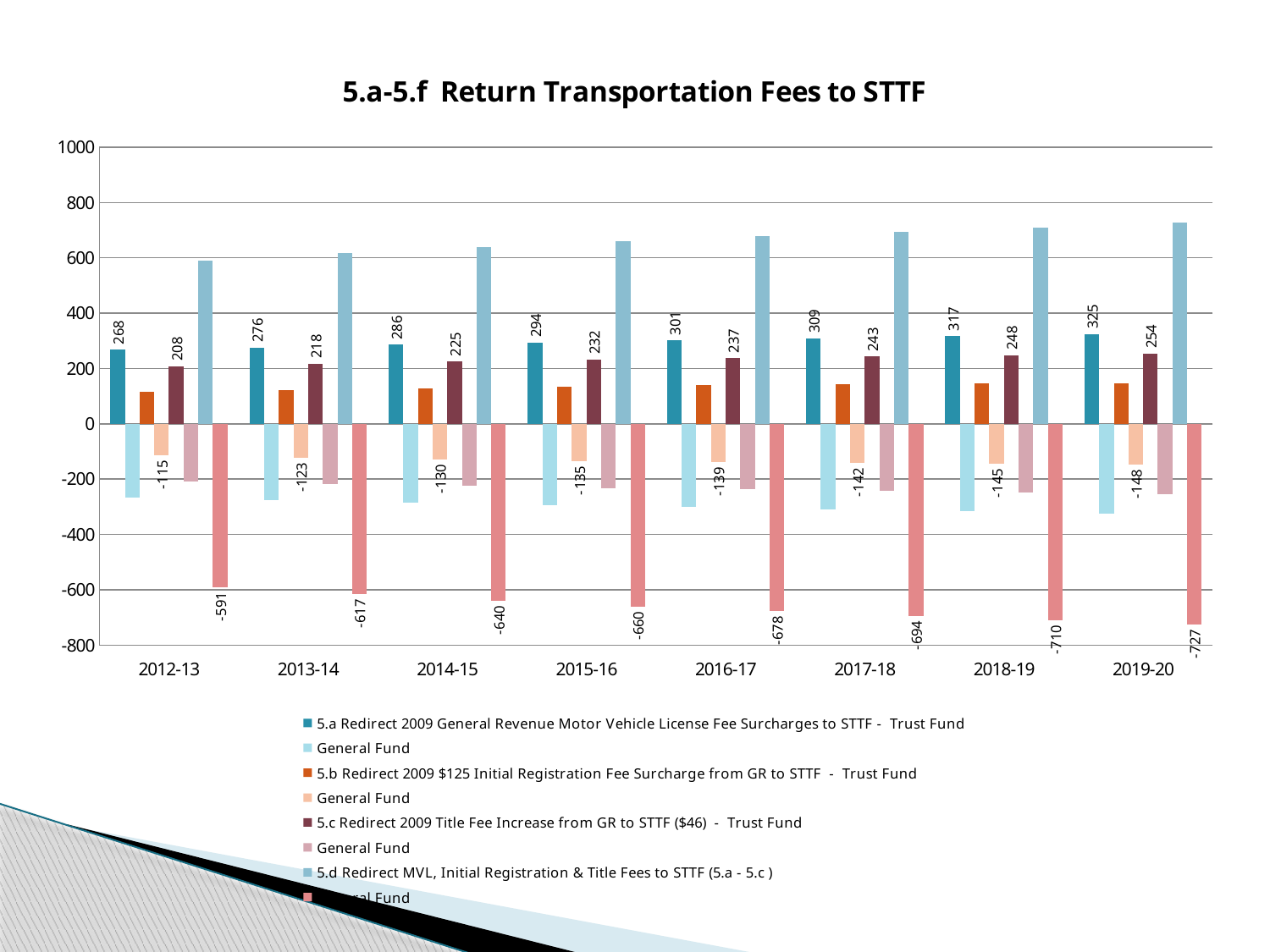
By how much does the 5.a Trust Fund value in 2019-20 exceed its value in 2012-13? 57 How many fiscal years are shown on the x axis? 8 In which year is the 5.a Trust Fund value the highest? 2019-20 Do the 5.a Trust Fund values rise or fall from 2012-13 to 2019-20? Rise What is the General Fund value labelled for 2012-13 in the 5.b Redirect 2009 $125 Initial Registration Fee Surcharge group? -115 What is the value of the 5.c Redirect 2009 Title Fee Increase from GR to STTF ($46) - Trust Fund series for 2019-20? 254 For 2014-15, which is larger: the 5.a Trust Fund value or the 5.c Trust Fund value? 5.a Trust Fund What is the value of the large negative General Fund bar (5.d) for 2017-18? -694 What is the value of the 5.a Redirect 2009 General Revenue Motor Vehicle License Fee Surcharges to STTF - Trust Fund series for 2015-16? 294 What type of chart is shown on the slide? Bar chart In which year is the 5.d General Fund value the lowest (most negative)? 2019-20 Is the value of the 5.d Redirect MVL, Initial Registration & Title Fees to STTF bar for 2012-13 greater or less than 400? greater